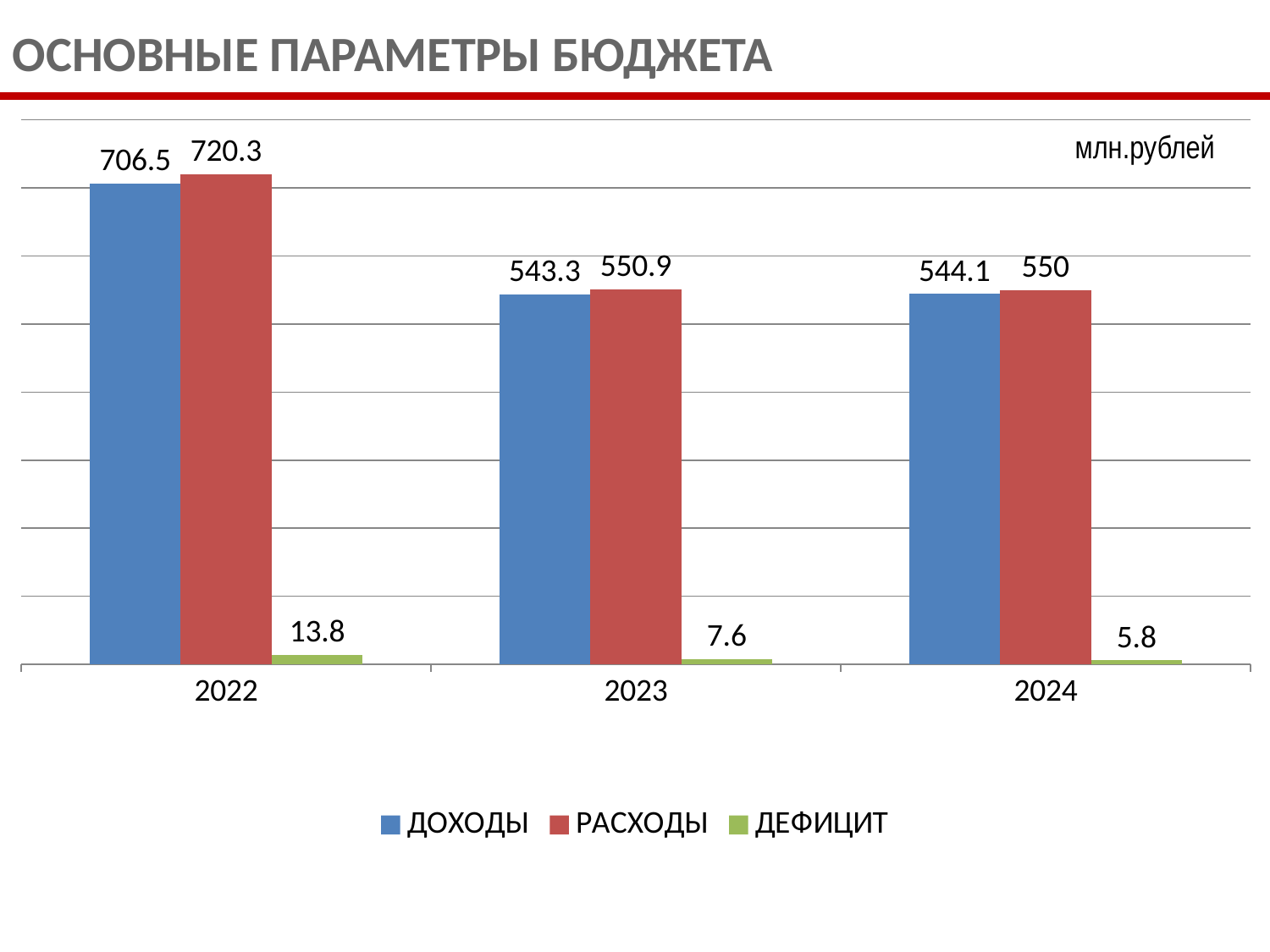
What unit is indicated in the top right corner of the chart? млн.рублей Which is larger in 2023: ДОХОДЫ or РАСХОДЫ? РАСХОДЫ What is the value of РАСХОДЫ for 2024? 550 What is the value of ДОХОДЫ for 2022? 706.5 What is the value of РАСХОДЫ for 2023? 550.9 What is the difference between РАСХОДЫ and ДОХОДЫ in 2022? 13.8 What is the value of ДЕФИЦИТ for 2024? 5.8 How many series does the legend list? 3 How many years are shown on the x axis? 3 What kind of chart is shown on the slide? Bar chart In which year is ДЕФИЦИТ lowest? 2024 In which year is ДОХОДЫ highest? 2022